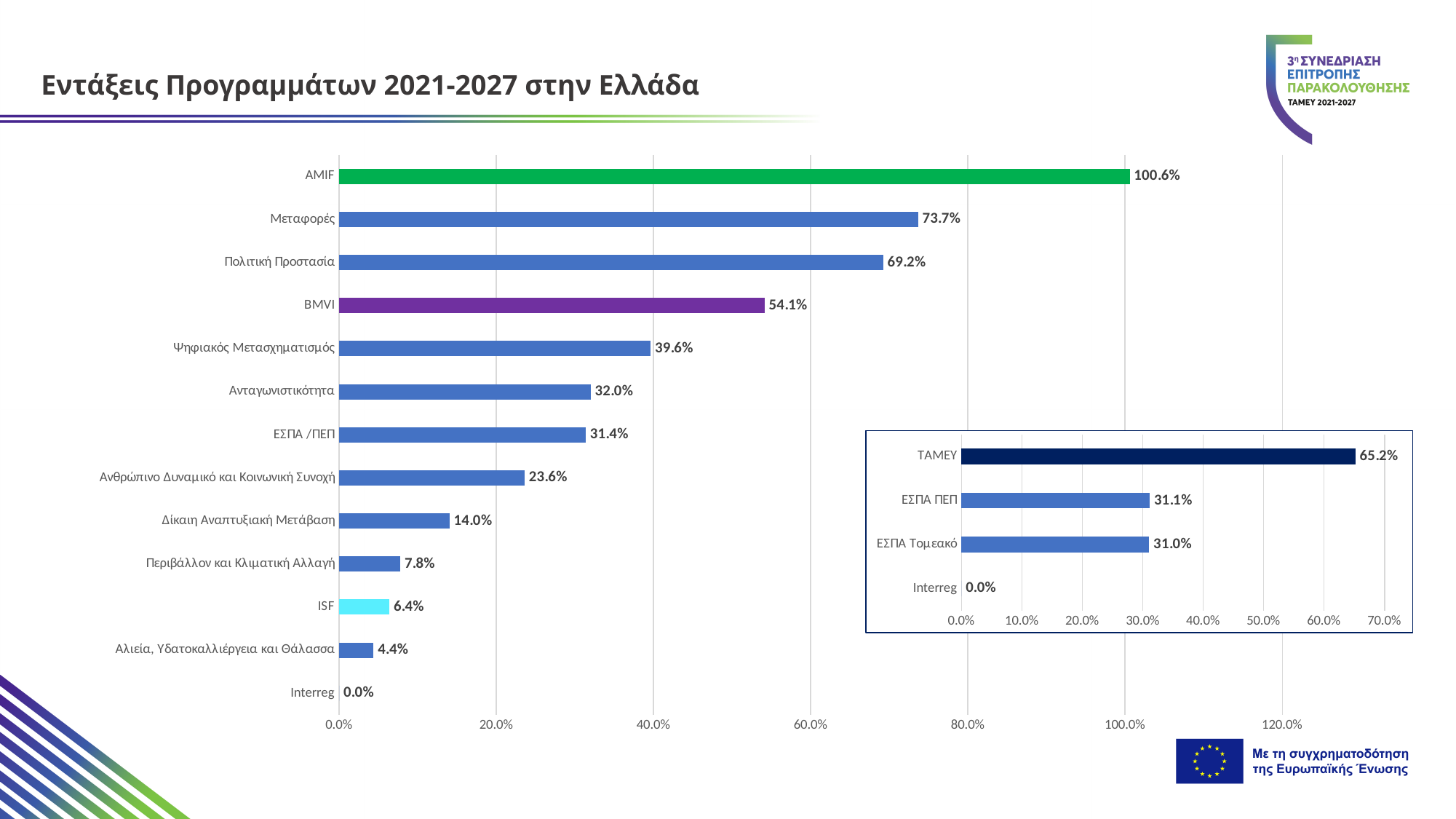
In the large chart on the left, which is larger: Ψηφιακός Μετασχηματισμός or Ανταγωνιστικότητα? Ψηφιακός Μετασχηματισμός In the large chart on the left, what is the value for BMVI? 54.1% In the small inset chart on the right, what is the value for ΤΑΜΕΥ? 65.2% In the large chart on the left, what is the difference between the values for Μεταφορές and Πολιτική Προστασία? 4.5% In the large chart on the left, which category has the lowest value? Interreg What type of chart is the large chart on the left? Bar chart How many categories are shown in the small inset chart on the right? 4 In the large chart on the left, which category has the highest value? AMIF In the large chart on the left, what is the value for AMIF? 100.6% In the large chart on the left, what is the value for ISF? 6.4% In the small inset chart on the right, what is the difference between the values for ΕΣΠΑ ΠΕΠ and ΕΣΠΑ Τομεακό? 0.1% How many categories are shown in the large chart on the left? 13